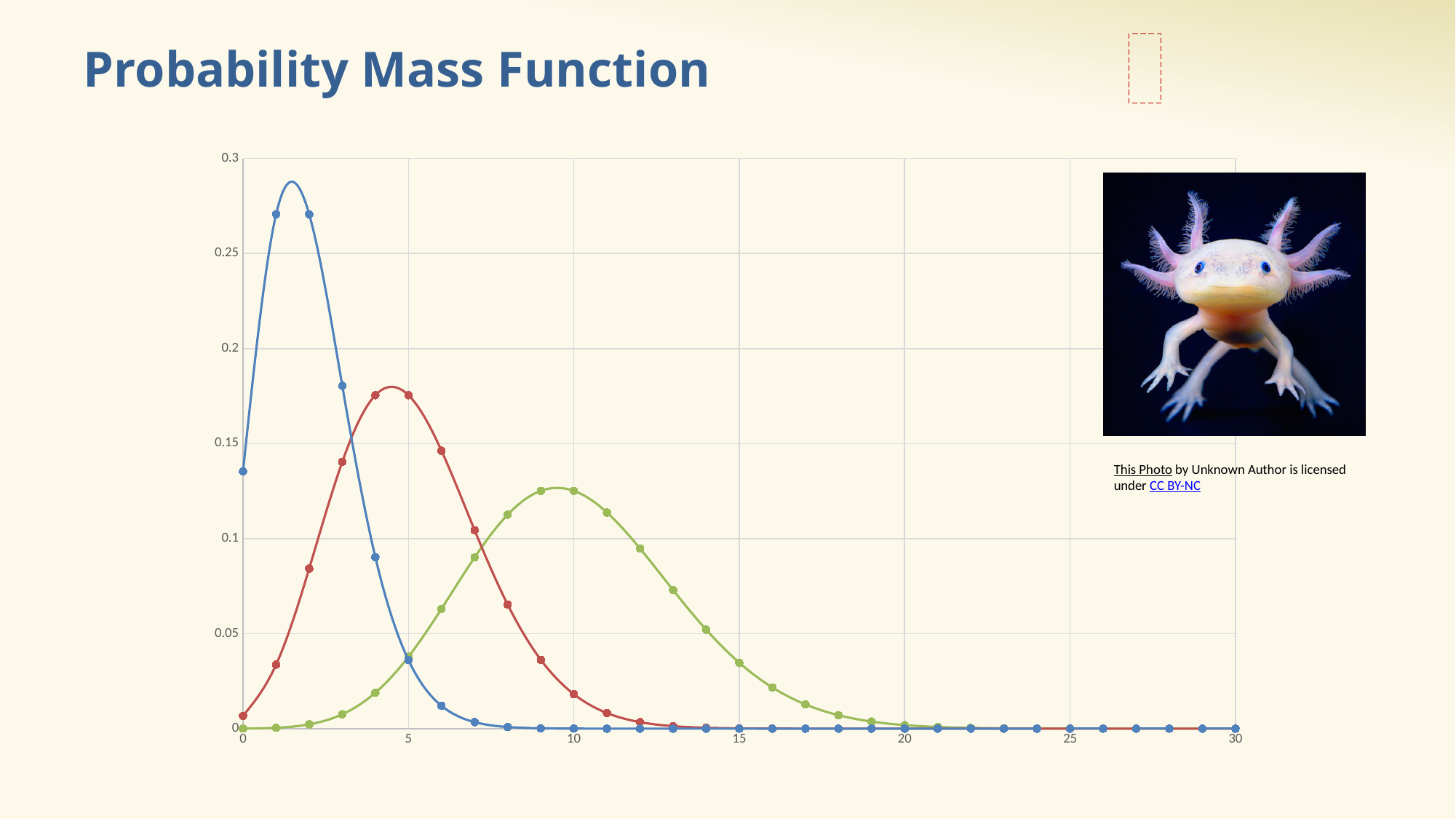
Which coloured line reaches the highest peak value? blue Which coloured line has the lowest peak value? green Is the peak value of the green line greater or less than 0.15? less What is the highest value shown on the x axis? 30 Is the value of the blue line at x = 0 greater or less than 0.15? less How many lines (series) are plotted on the chart? 3 Is the peak value of the blue line greater or less than 0.25? greater At x = 5, which line has the larger value, the red line or the blue line? red Do the values of the blue line rise or fall as x increases from 3 to 10? fall What kind of chart is shown on the slide? line chart